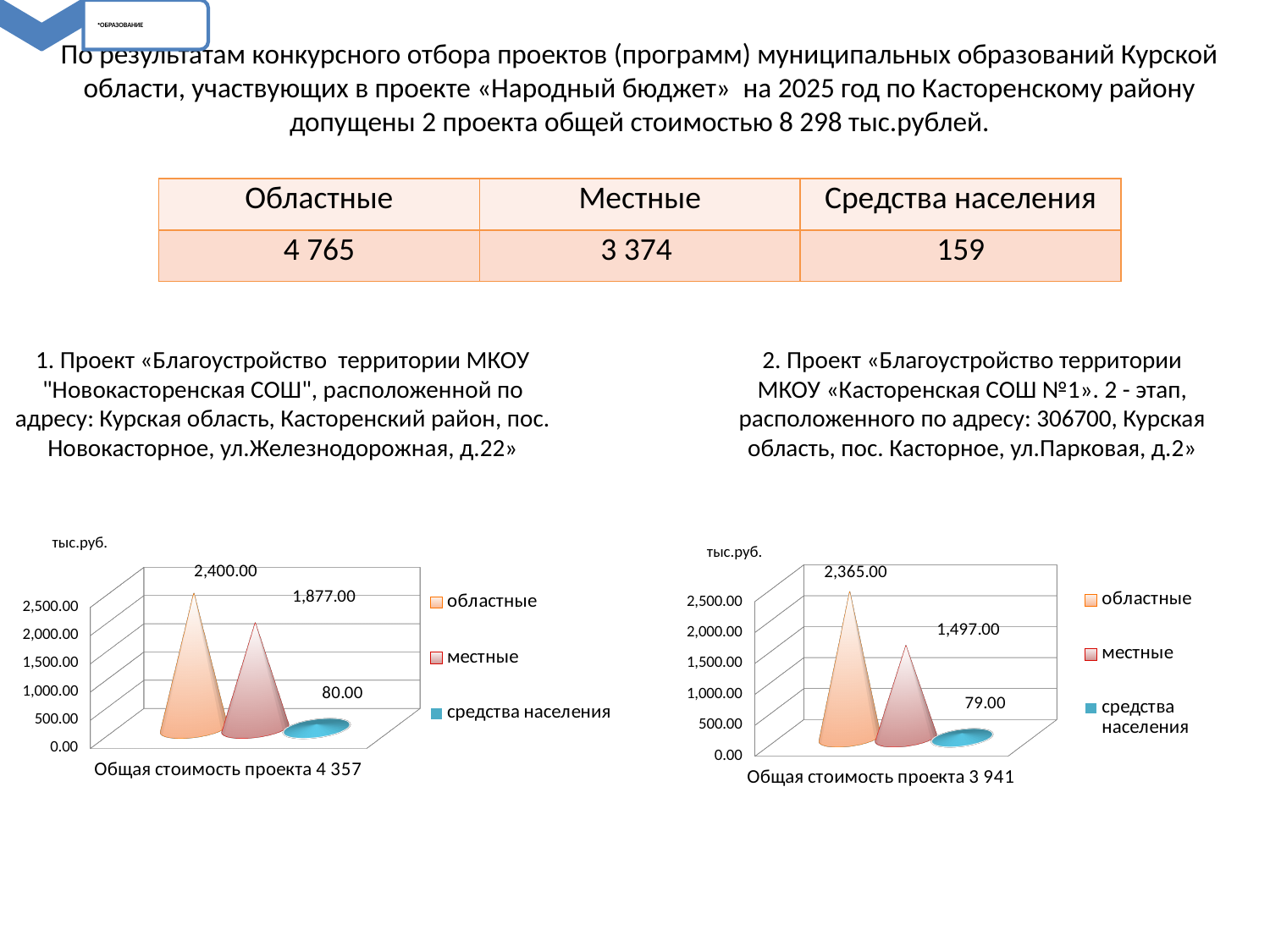
How many series does the legend of the right chart (Общая стоимость проекта 3 941) list? 3 In the left chart (Общая стоимость проекта 4 357), what is the value for областные? 2,400.00 What kind of chart is the left chart (Общая стоимость проекта 4 357)? bar chart In the right chart (Общая стоимость проекта 3 941), which series has the lowest value? средства населения In the left chart (Общая стоимость проекта 4 357), what is the difference between областные and местные? 523.00 In the left chart (Общая стоимость проекта 4 357), which series has the highest value? областные In the right chart (Общая стоимость проекта 3 941), what is the value for средства населения? 79.00 In the left chart (Общая стоимость проекта 4 357), what is the value for средства населения? 80.00 In the left chart (Общая стоимость проекта 4 357), what is the value for местные? 1,877.00 In the right chart (Общая стоимость проекта 3 941), which is larger, областные or местные? областные In the right chart (Общая стоимость проекта 3 941), what is the value for местные? 1,497.00 In the right chart (Общая стоимость проекта 3 941), what is the value for областные? 2,365.00